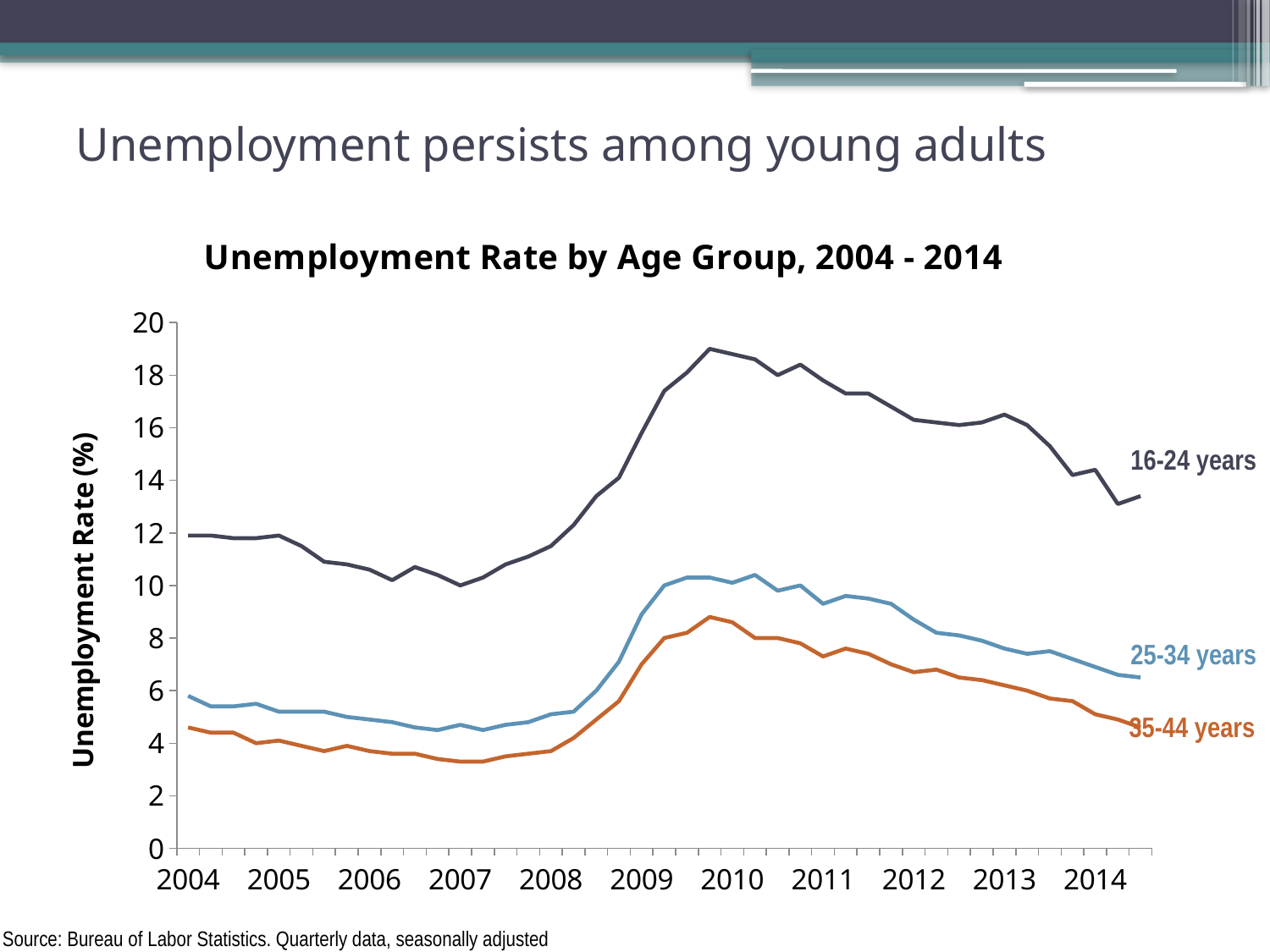
Is the unemployment rate for 35-44 years at 2010 greater or less than 6? greater At 2009, which is higher: the unemployment rate for 16-24 years or for 35-44 years? 16-24 years Does the unemployment rate for 16-24 years rise or fall from 2010 to 2014? fall Does the unemployment rate for 25-34 years rise or fall from 2008 to 2010? rise How many age-group series are plotted on the chart? 3 What kind of chart is shown on the slide? line chart Is the unemployment rate for 16-24 years at 2010 greater or less than 18? greater Which age group has the lowest unemployment rate across the whole period? 35-44 years What is the title of the chart? Unemployment Rate by Age Group, 2004 - 2014 Is the unemployment rate for 25-34 years at 2004 greater or less than 8? less Which age group has the highest unemployment rate across the whole period? 16-24 years